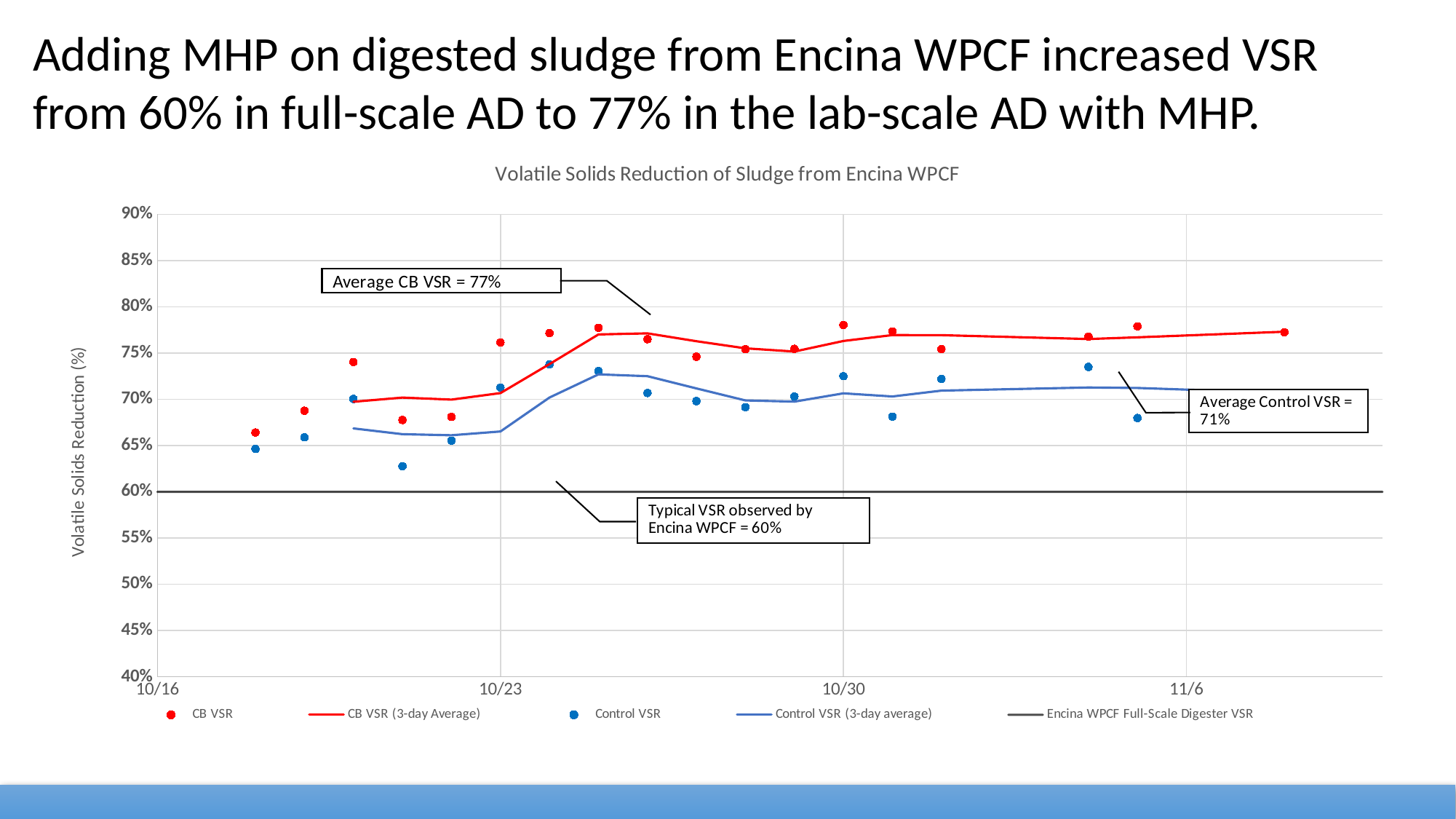
Is the earliest CB VSR data point (near 10/16) greater or less than 70%? less Which is higher, the Average CB VSR or the Average Control VSR? Average CB VSR What is the difference between the Average CB VSR and the Average Control VSR? 6 percentage points According to the annotation on the chart, what is the Average CB VSR? 77% What is the difference between the Average CB VSR and the typical VSR observed by Encina WPCF? 17 percentage points What kind of chart is shown on the slide? Line chart with scatter points According to the annotation on the chart, what is the Average Control VSR? 71% What is the label on the vertical axis of the chart? Volatile Solids Reduction (%) What is the title of the chart? Volatile Solids Reduction of Sludge from Encina WPCF How many series does the chart legend list? 5 What is the typical VSR observed by Encina WPCF, as annotated on the chart? 60%